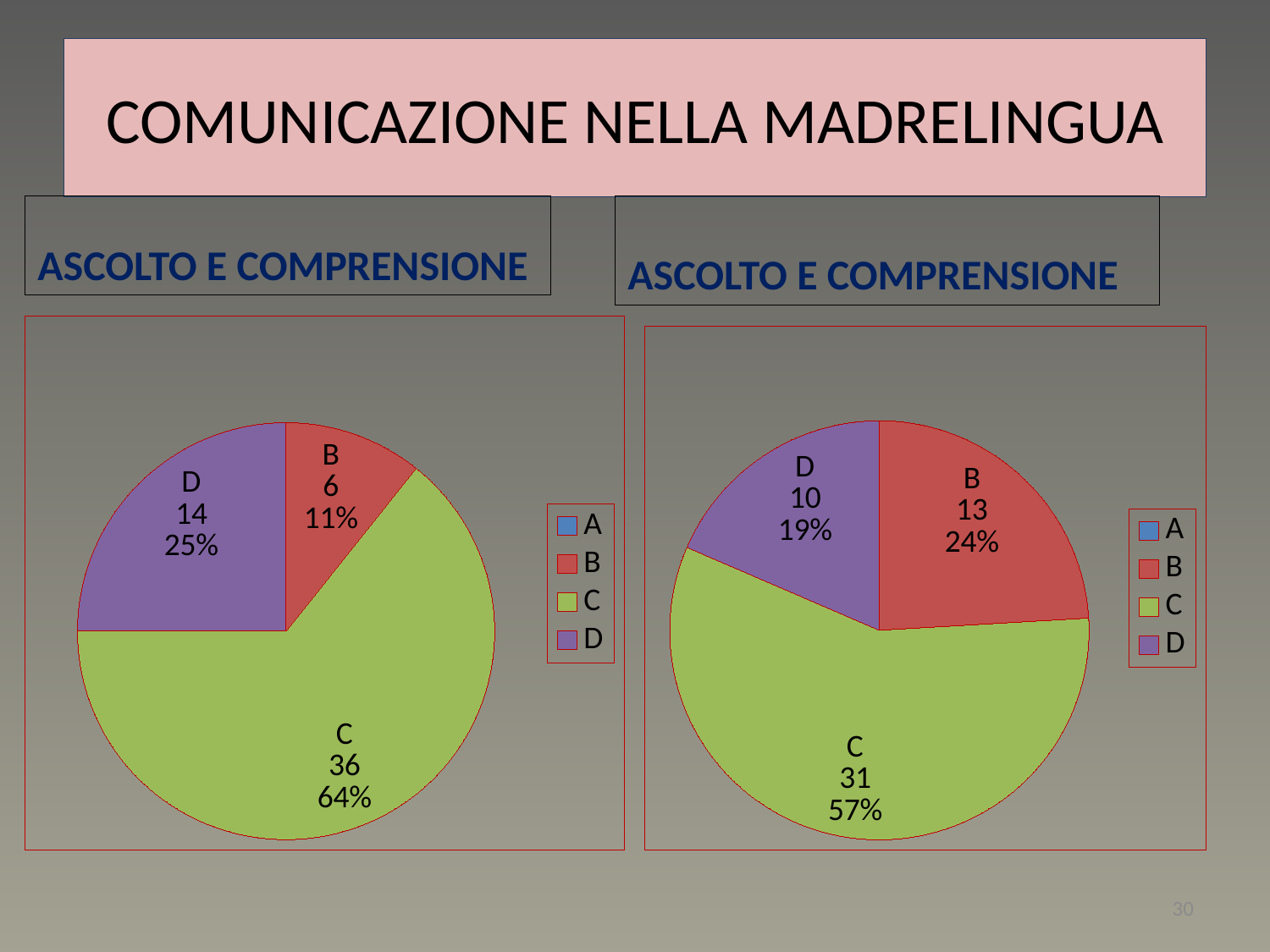
In the right pie chart, what percentage is shown for category B? 24% What is the title shown above the right pie chart? ASCOLTO E COMPRENSIONE In the right pie chart, which labelled category has the smallest slice? D In the left pie chart, what is the difference between the values for C and D? 22 In the left pie chart, what value is shown for category C? 36 In the left pie chart, what percentage is shown for category D? 25% In the right pie chart, what value is shown for category D? 10 In the right pie chart, which is larger, the value for B or the value for D? B In the left pie chart, which category has the largest slice? C What type of chart is shown on the left of the slide? Pie chart What share of the right pie chart does category C represent? 57% How many entries does the legend of the left pie chart list? 4